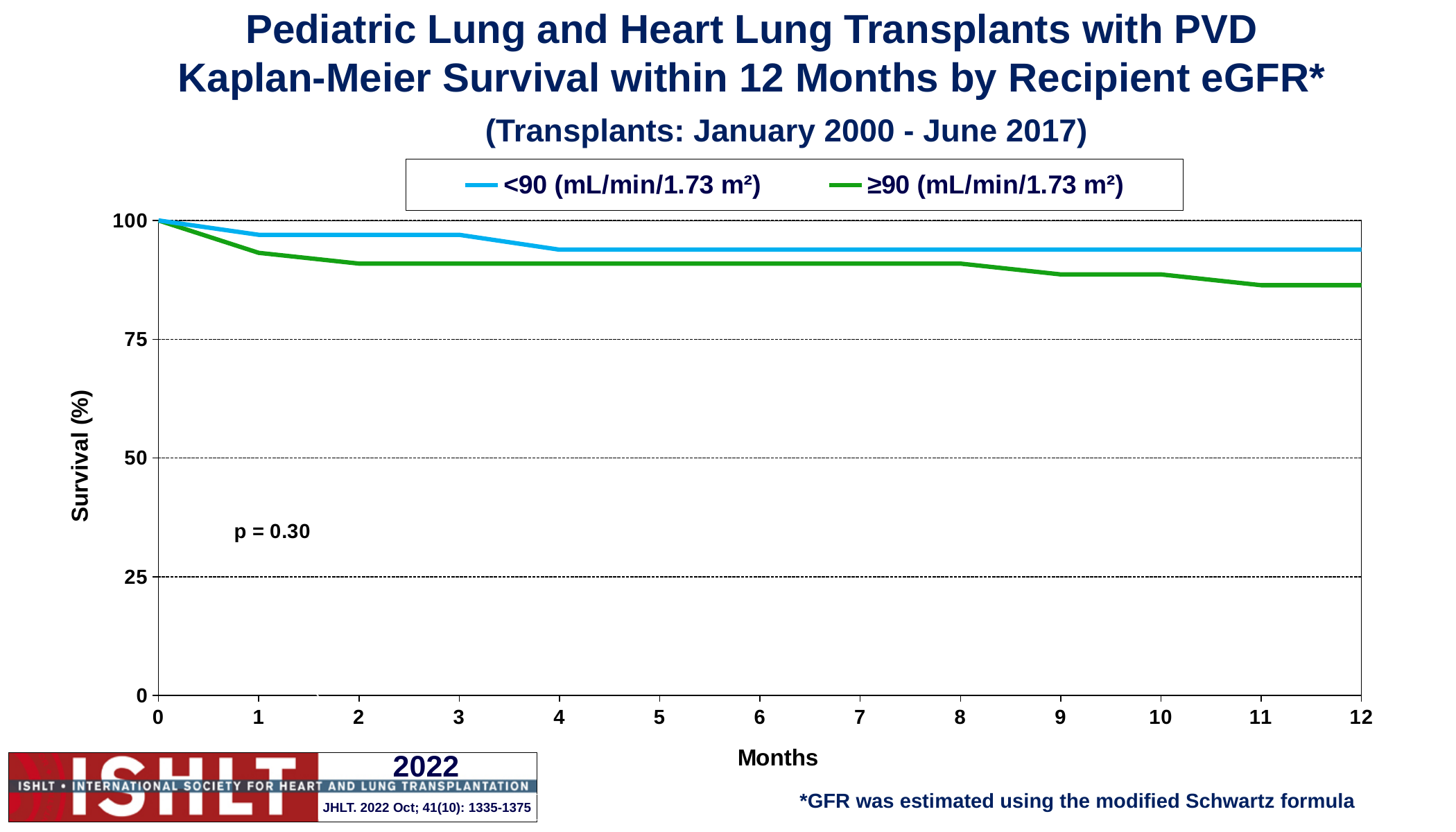
What is the label of the y axis? Survival (%) What p-value is printed on the chart? p = 0.30 Is the survival for the <90 (mL/min/1.73 m²) group at month 12 greater or less than 100? less Do the survival curves rise or fall as months increase? Fall How many month tick marks are shown on the x axis? 13 Is the survival for the ≥90 (mL/min/1.73 m²) group at month 6 greater or less than 100? less Which eGFR group has the higher survival at month 12? <90 (mL/min/1.73 m²) What type of chart is shown on the slide? Line chart How many series does the legend list? 2 What is the survival value for both eGFR groups at month 0? 100 Which eGFR group has the lowest survival at month 12? ≥90 (mL/min/1.73 m²) Is the survival for the ≥90 (mL/min/1.73 m²) group at month 12 greater or less than 75? greater